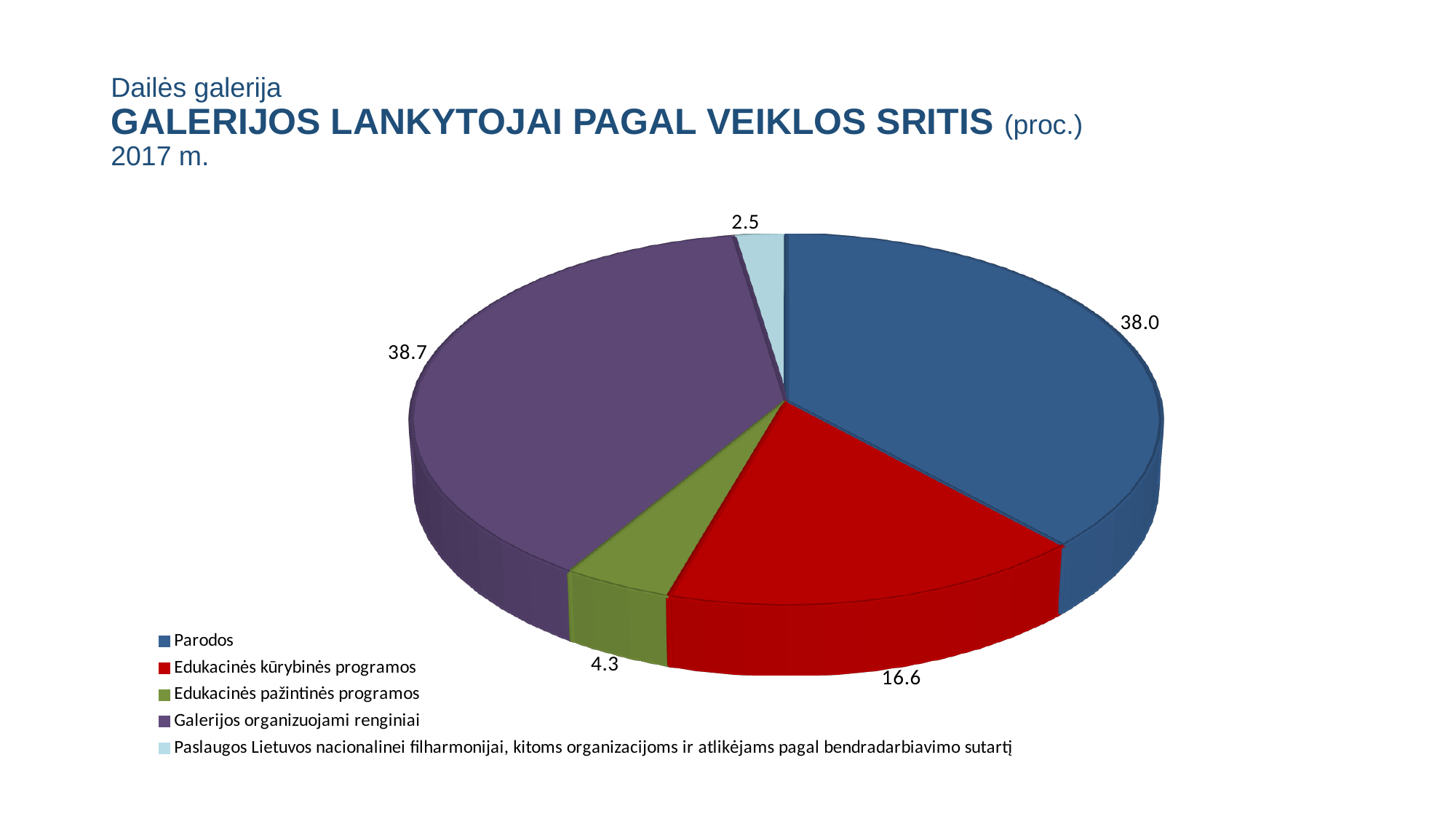
Which is larger, Edukacinės kūrybinės programos or Edukacinės pažintinės programos? Edukacinės kūrybinės programos What is the value for Edukacinės pažintinės programos? 4.3 What is the value for Paslaugos Lietuvos nacionalinei filharmonijai, kitoms organizacijoms ir atlikėjams pagal bendradarbiavimo sutartį? 2.5 Which category has the smallest share of the pie? Paslaugos Lietuvos nacionalinei filharmonijai, kitoms organizacijoms ir atlikėjams pagal bendradarbiavimo sutartį What is the value for Edukacinės kūrybinės programos? 16.6 How many slices does the pie chart have? 5 What is the value for Galerijos organizuojami renginiai? 38.7 What is the difference between the values for Parodos and Edukacinės kūrybinės programos? 21.4 What kind of chart is shown on the slide? pie chart What is the value for Parodos? 38.0 Which category has the largest share of the pie? Galerijos organizuojami renginiai Which year does the chart title refer to? 2017 m.